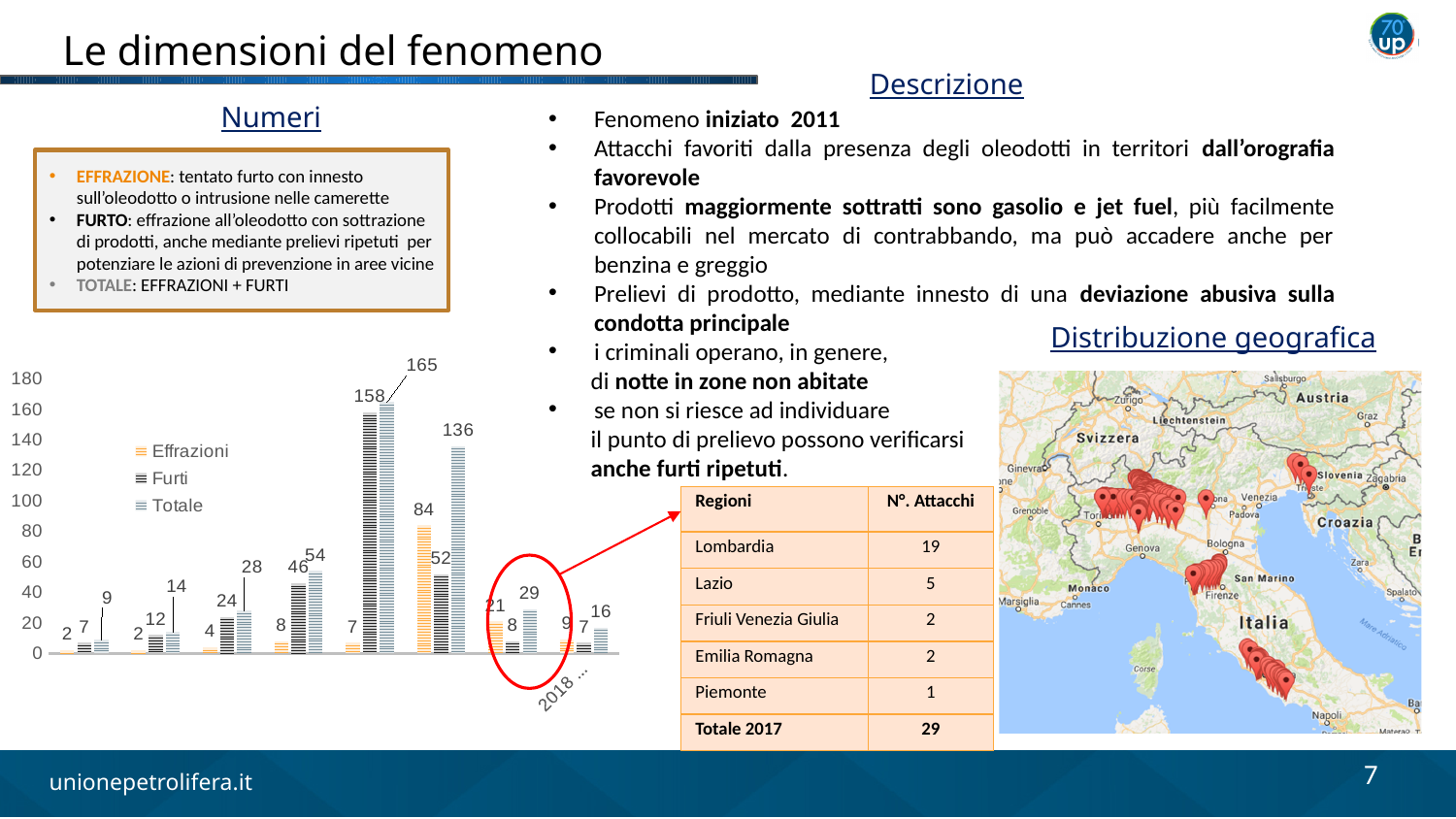
In the group where Totale is 136, which is larger: Effrazioni or Furti? Effrazioni What is the lowest value shown for the Totale series in the bar chart? 9 What is the highest value shown for the Totale series in the bar chart? 165 Is the highest Totale value in the bar chart greater or less than 160? greater What are the three series named in the legend of the bar chart? Effrazioni, Furti, Totale What is the Totale value for the last category on the x axis, labelled "2018 ..."? 16 What is the highest value shown for the Furti series in the bar chart? 158 What is the highest value shown for the Effrazioni series in the bar chart? 84 What is the difference between the two highest Totale values in the bar chart (165 and 136)? 29 How many series does the legend of the bar chart list? 3 What kind of chart is shown under the heading "Numeri"? bar chart How many groups of bars (categories) are plotted along the x axis of the bar chart? 8